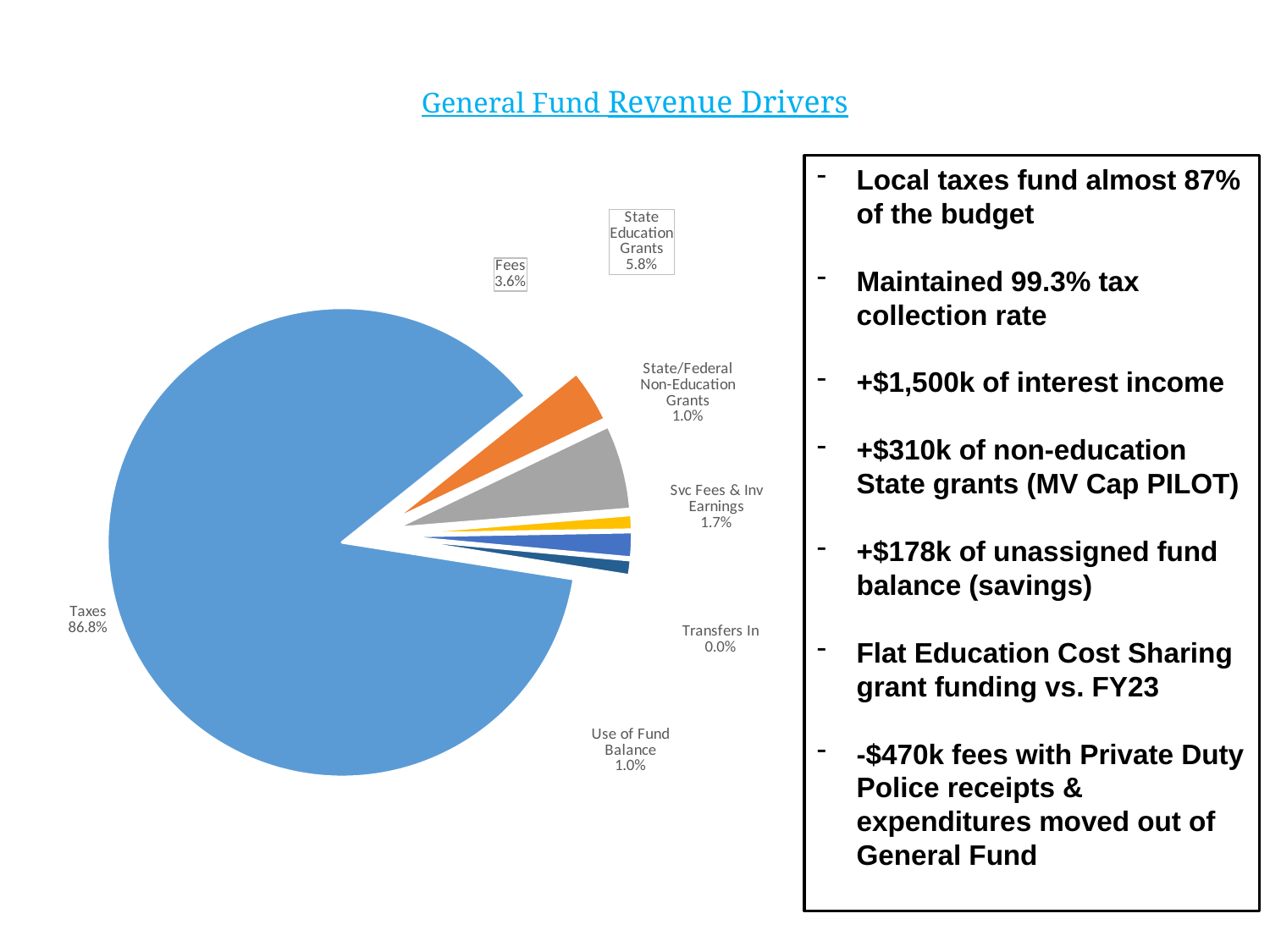
What is the value shown for Svc Fees & Inv Earnings? 1.7% What is the value shown for Fees? 3.6% Which is larger, the share for Fees or the share for Svc Fees & Inv Earnings? Fees What is the title of the slide containing the chart? General Fund Revenue Drivers Which category has the largest share of the pie? Taxes What is the value shown for Transfers In? 0.0% What is the difference between the shares for State Education Grants and Fees? 2.2% Which category has the smallest share of the pie? Transfers In What share of the pie does State Education Grants represent? 5.8% How many categories are shown in the pie chart? 7 What kind of chart is shown on the slide? Pie chart What share of the pie does Taxes represent? 86.8%